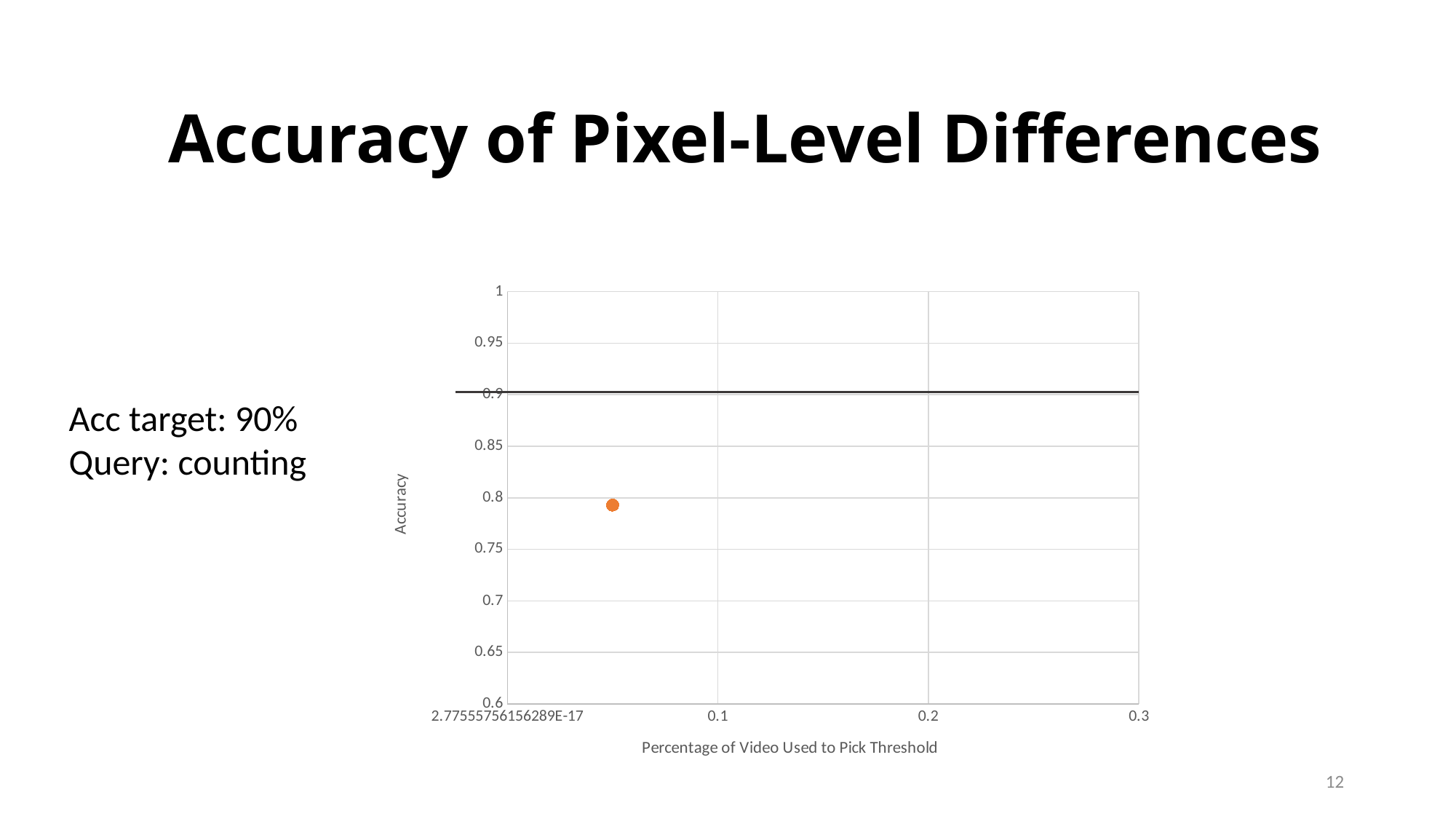
What is the largest tick value shown on the x axis? 0.3 What is the label of the y axis? Accuracy What is the lowest value shown on the y axis? 0.6 Is the accuracy value of the plotted point greater or less than 0.75? greater At what accuracy value is the horizontal line drawn across the chart? 0.9 Is the accuracy value of the plotted point greater or less than 0.9? less What is the label of the x axis? Percentage of Video Used to Pick Threshold Is the accuracy value of the plotted point greater or less than 0.85? less What kind of chart is shown on the slide? scatter chart How many data points are plotted in the chart? 1 What is the highest value shown on the y axis? 1